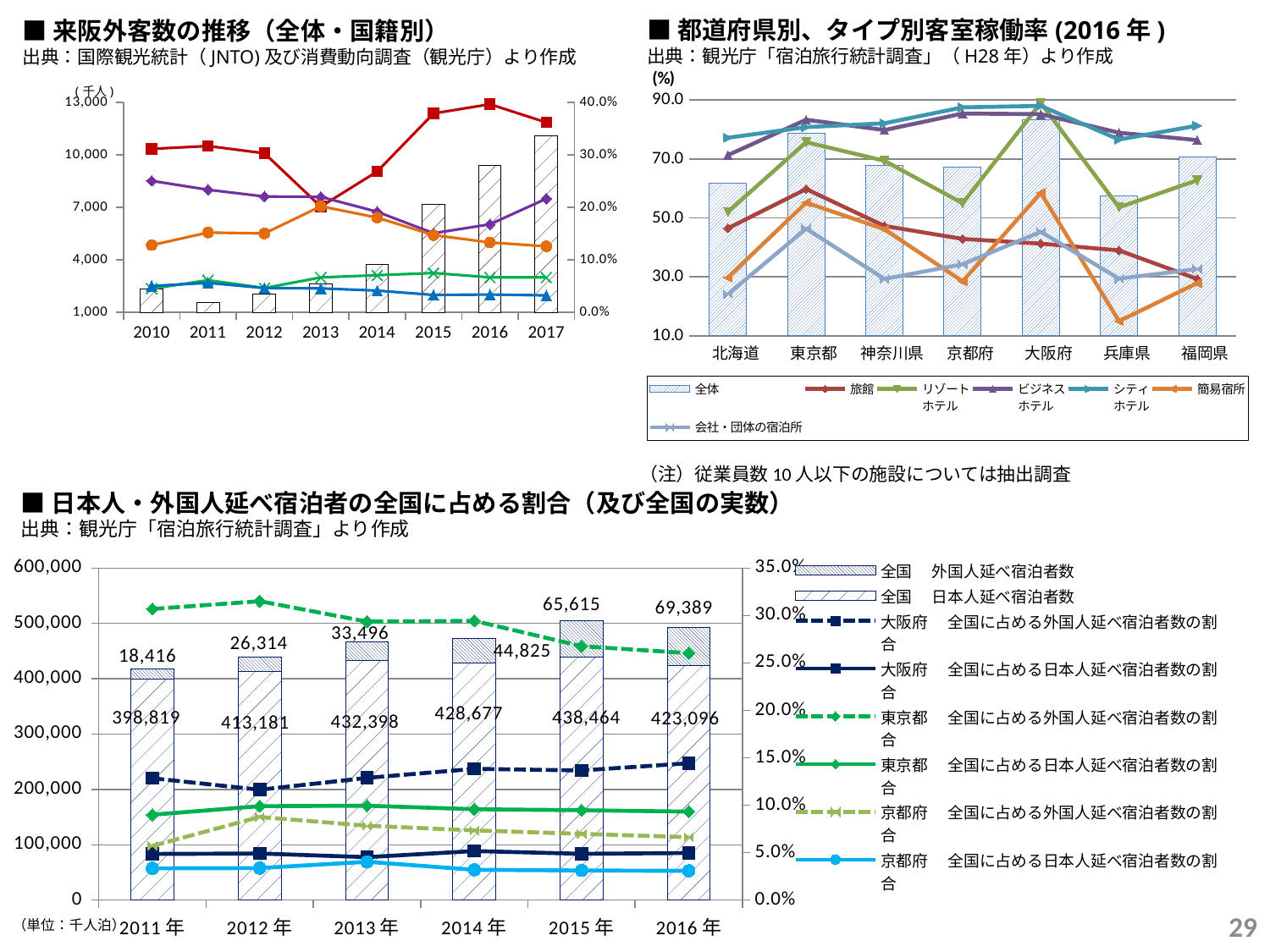
In the bottom chart (日本人・外国人延べ宿泊者の全国に占める割合), what is the total of the stacked bar for 2015年 (日本人 plus 外国人)? 504,079 In the bottom chart (日本人・外国人延べ宿泊者の全国に占める割合), how many years are shown on the x axis? 6 In the bottom chart (日本人・外国人延べ宿泊者の全国に占める割合), does the 全国 外国人延べ宿泊者数 rise or fall from 2011年 to 2016年? rise In the bottom chart (日本人・外国人延べ宿泊者の全国に占める割合), what is the value of 全国 日本人延べ宿泊者数 for 2011年? 398,819 In the top-right chart (都道府県別、タイプ別客室稼働率), is the value for 簡易宿所 in 兵庫県 greater or less than 30.0? less In the bottom chart (日本人・外国人延べ宿泊者の全国に占める割合), what is the value of 全国 外国人延べ宿泊者数 for 2016年? 69,389 In the bottom chart (日本人・外国人延べ宿泊者の全国に占める割合), which year has the highest 全国 日本人延べ宿泊者数? 2015年 In the top-right chart (都道府県別、タイプ別客室稼働率), how many entries does the legend list? 7 In the top-right chart (都道府県別、タイプ別客室稼働率), how many prefectures are shown on the x axis? 7 What kind of chart is the top-left chart (来阪外客数の推移)? Combination bar and line chart In the bottom chart (日本人・外国人延べ宿泊者の全国に占める割合), what is the difference between the 全国 外国人延べ宿泊者数 for 2016年 and 2011年? 50,973 In the bottom chart (日本人・外国人延べ宿泊者の全国に占める割合), how many entries does the legend list? 8